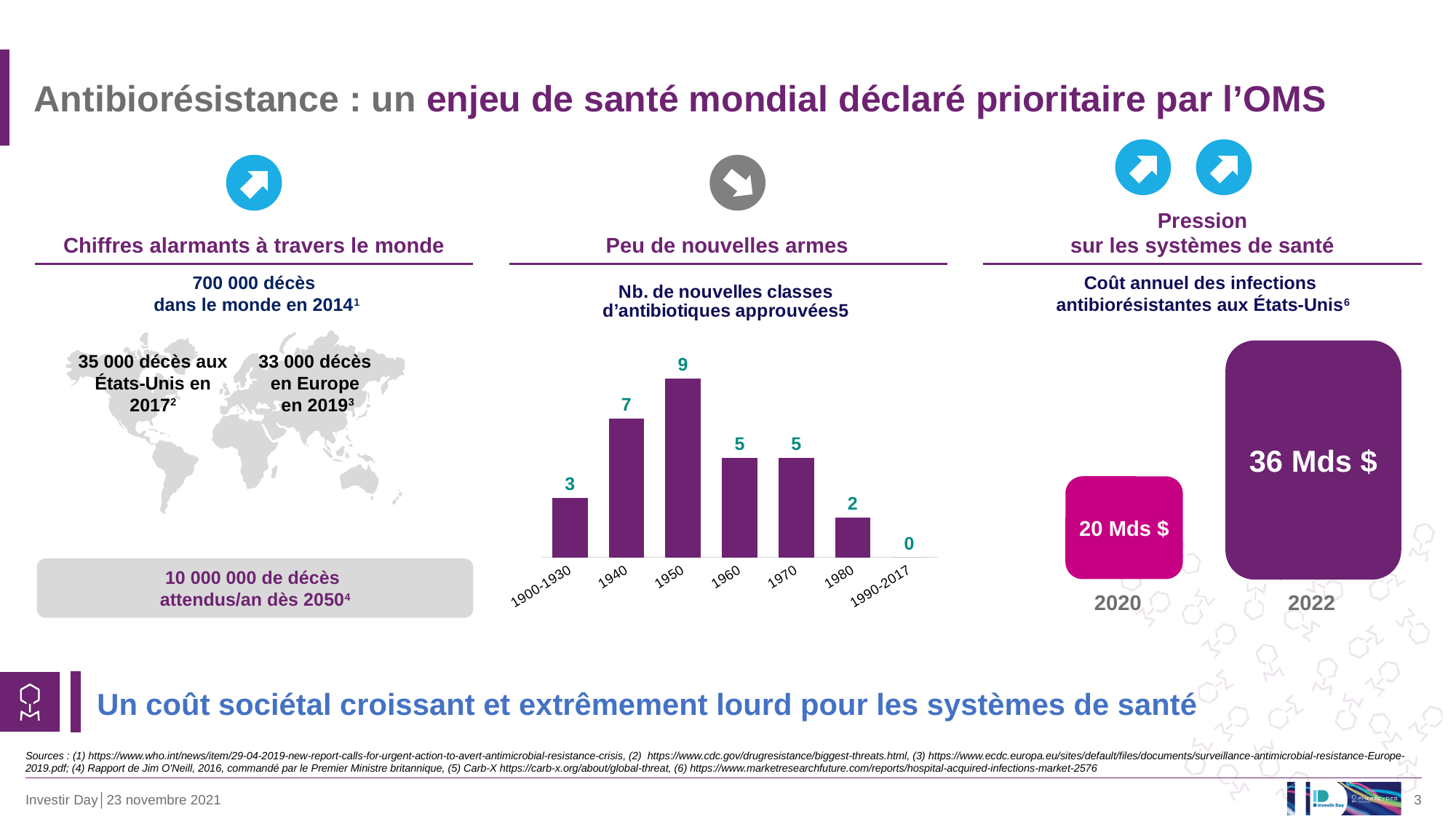
In the bar chart of new antibiotic classes approved, do the values rise or fall from 1950 to 1990-2017? fall In the bar chart of new antibiotic classes approved, which period has the lowest value? 1990-2017 In the bar chart of new antibiotic classes approved, what is the value for 1950? 9 In the bar chart of new antibiotic classes approved, which is larger, the value for 1940 or the value for 1970? 1940 In the bar chart of new antibiotic classes approved, what is the difference between the values for 1950 and 1940? 2 In the bar chart of new antibiotic classes approved, what is the value for 1900-1930? 3 In the bar chart of new antibiotic classes approved, which period has the highest value? 1950 In the bar chart of new antibiotic classes approved, what is the value for 1980? 2 What kind of chart is shown under 'Nb. de nouvelles classes d'antibiotiques approuvées'? bar chart In the bar chart of new antibiotic classes approved, what is the value for 1990-2017? 0 How many periods (bars) are shown in the bar chart of new antibiotic classes approved? 7 In the bar chart of new antibiotic classes approved, what is the difference between the values for 1960 and 1980? 3